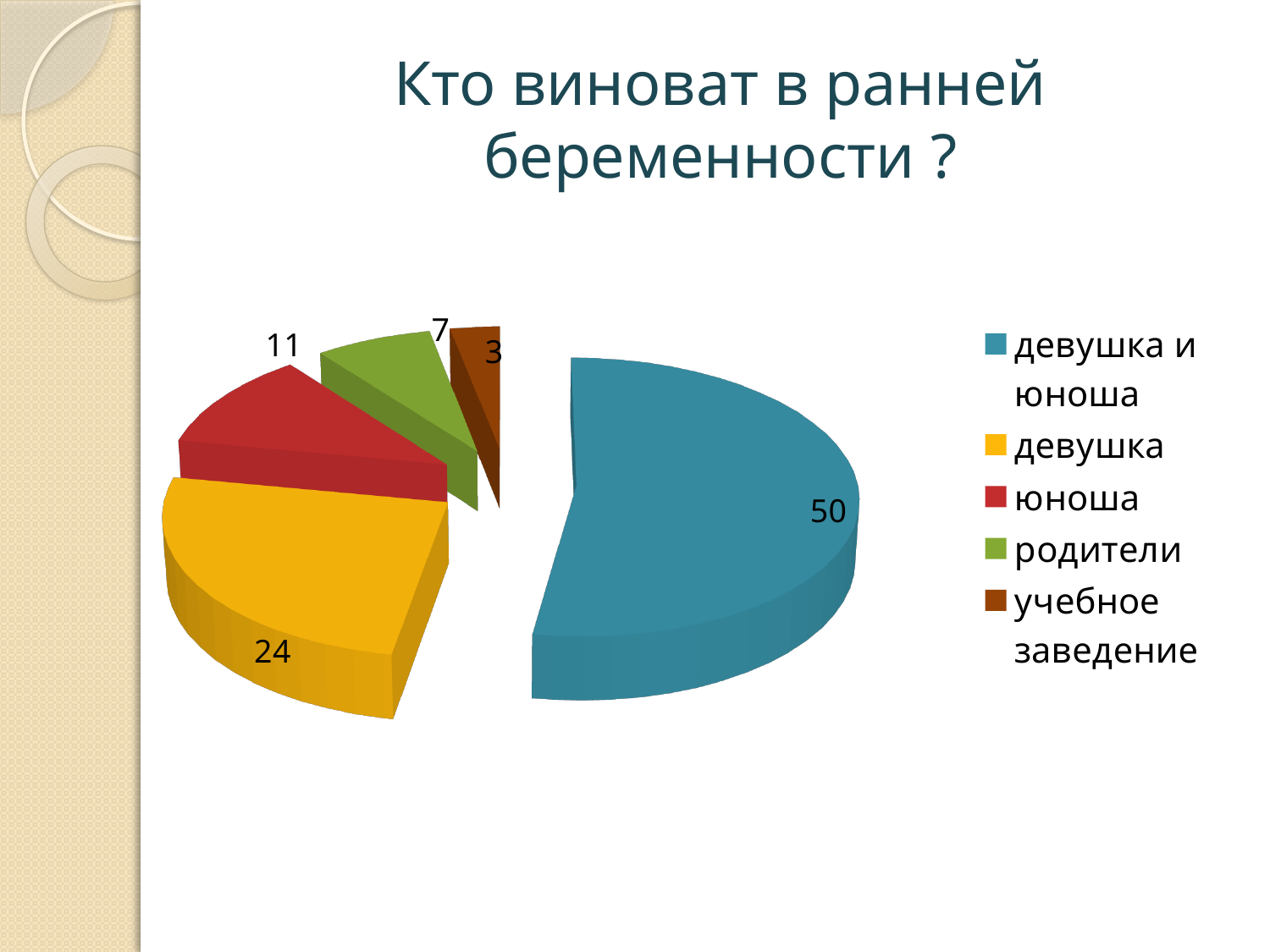
What is the value for the "родители" slice? 7 Which is larger, the value for "юноша" or the value for "родители"? юноша What is the value for the "юноша" slice? 11 What is the title of the chart slide? Кто виноват в ранней беременности ? What is the difference between the values for "девушка и юноша" and "девушка"? 26 What is the value for the "девушка и юноша" slice? 50 Which category has the largest slice? девушка и юноша How many categories does the legend list? 5 Which category has the smallest slice? учебное заведение What type of chart is shown on the slide? pie chart What is the value for the "учебное заведение" slice? 3 What is the value for the "девушка" slice? 24